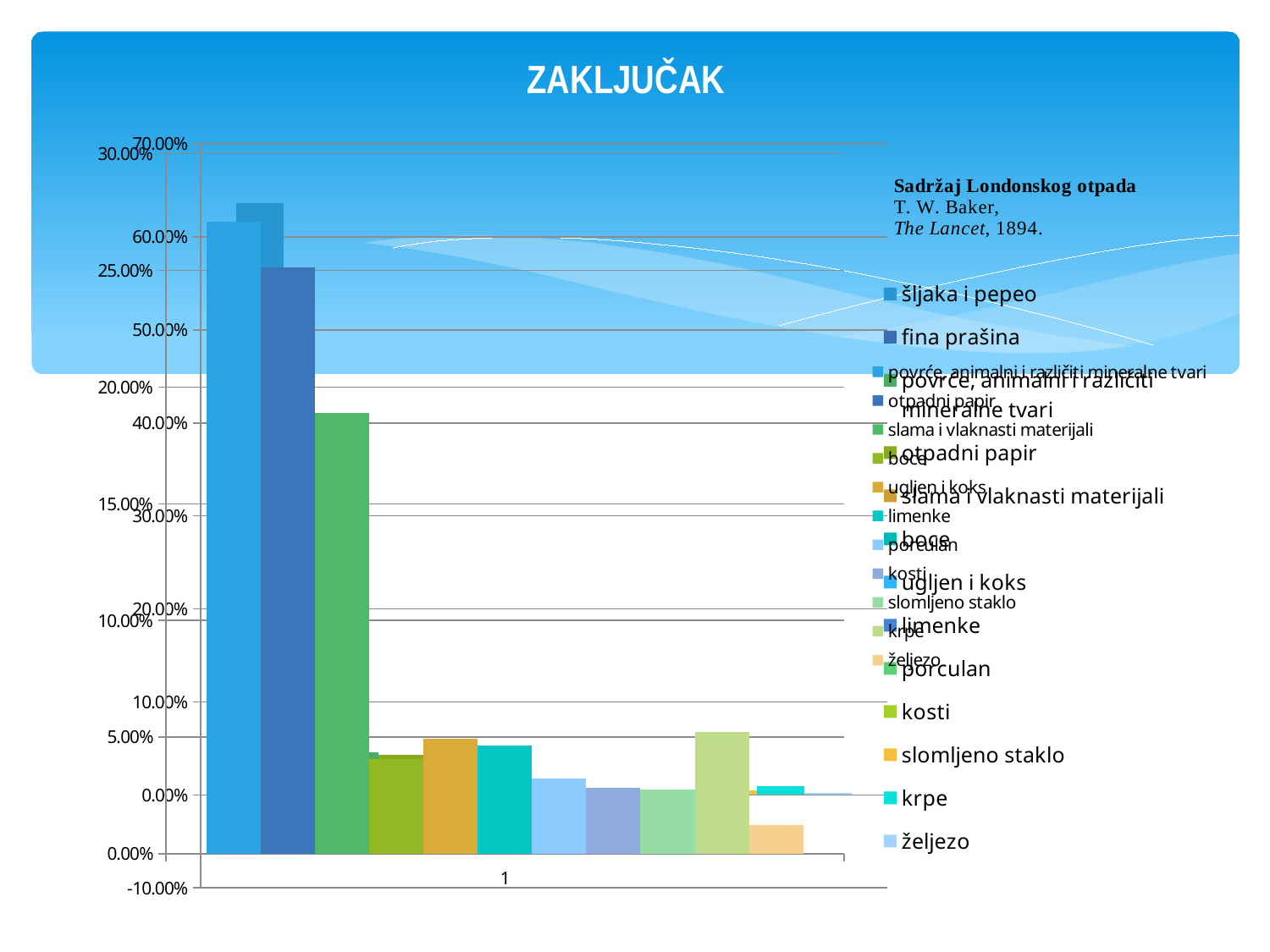
How many series does the large legend on the right list? 13 Which is larger, the bar for šljaka i pepeo or the bar for fina prašina? šljaka i pepeo Which series has the tallest bar in the chart? šljaka i pepeo What is the title of the slide? ZAKLJUČAK According to the text on the slide, what is the source of the data on London waste content? T. W. Baker, The Lancet, 1894. What kind of chart is shown on the slide? bar chart Which is larger, the bar for povrće, animalni i različiti mineralne tvari or the bar for slama i vlaknasti materijali? povrće, animalni i različiti mineralne tvari